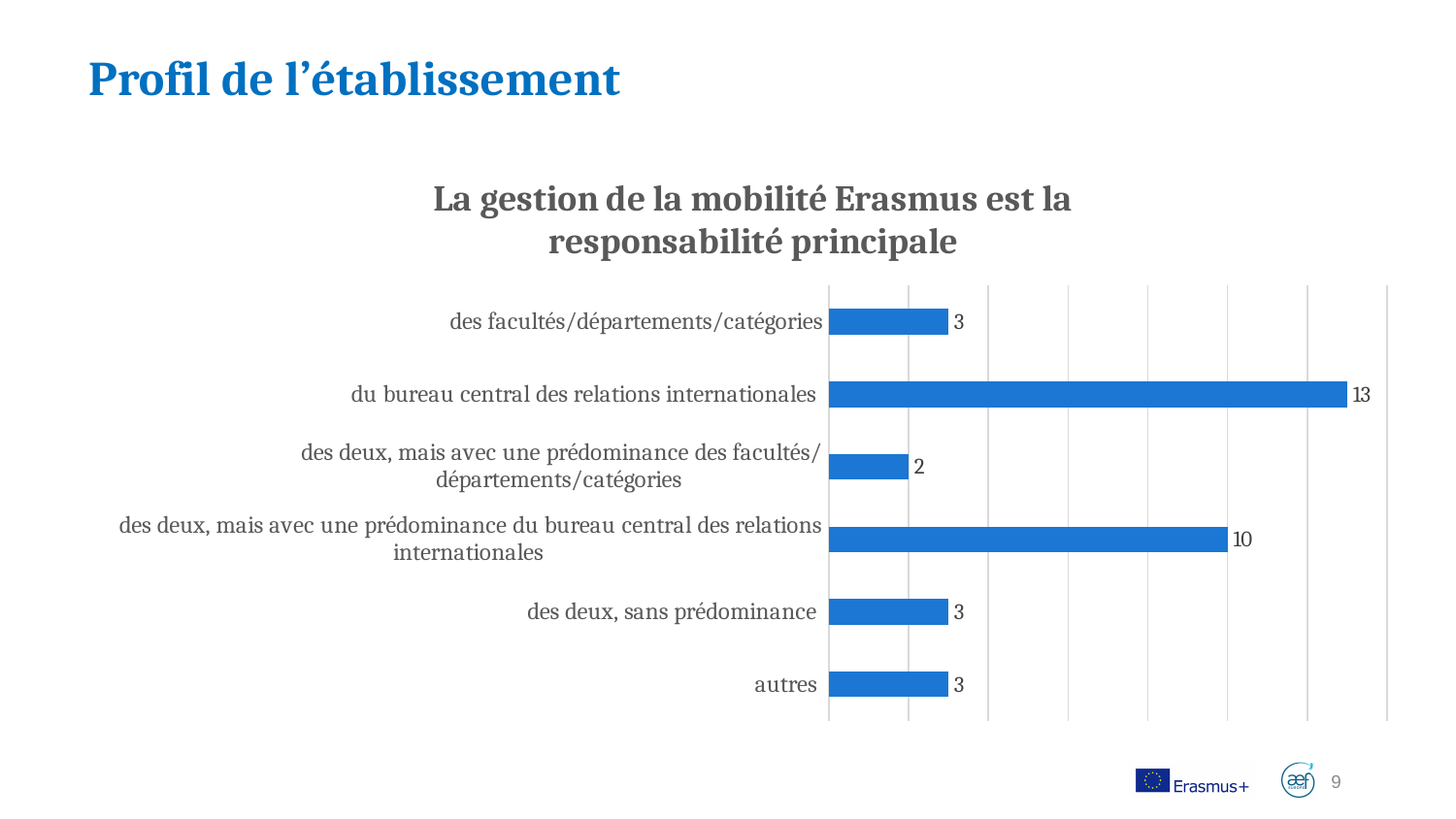
What value is shown for "autres"? 3 Which category has the lowest value? des deux, mais avec une prédominance des facultés/départements/catégories Which is larger: the value for "des facultés/départements/catégories" or the value for "des deux, mais avec une prédominance des facultés/départements/catégories"? des facultés/départements/catégories What value is shown for "du bureau central des relations internationales"? 13 How many categories are shown in the chart? 6 What is the difference between the values for "des deux, sans prédominance" and "des deux, mais avec une prédominance des facultés/départements/catégories"? 1 What value is shown for "des deux, mais avec une prédominance des facultés/départements/catégories"? 2 What value is shown for "des deux, mais avec une prédominance du bureau central des relations internationales"? 10 What is the title of the chart? La gestion de la mobilité Erasmus est la responsabilité principale What kind of chart is shown on the slide? bar chart Which category has the highest value? du bureau central des relations internationales What is the difference between the values for "du bureau central des relations internationales" and "des deux, mais avec une prédominance du bureau central des relations internationales"? 3